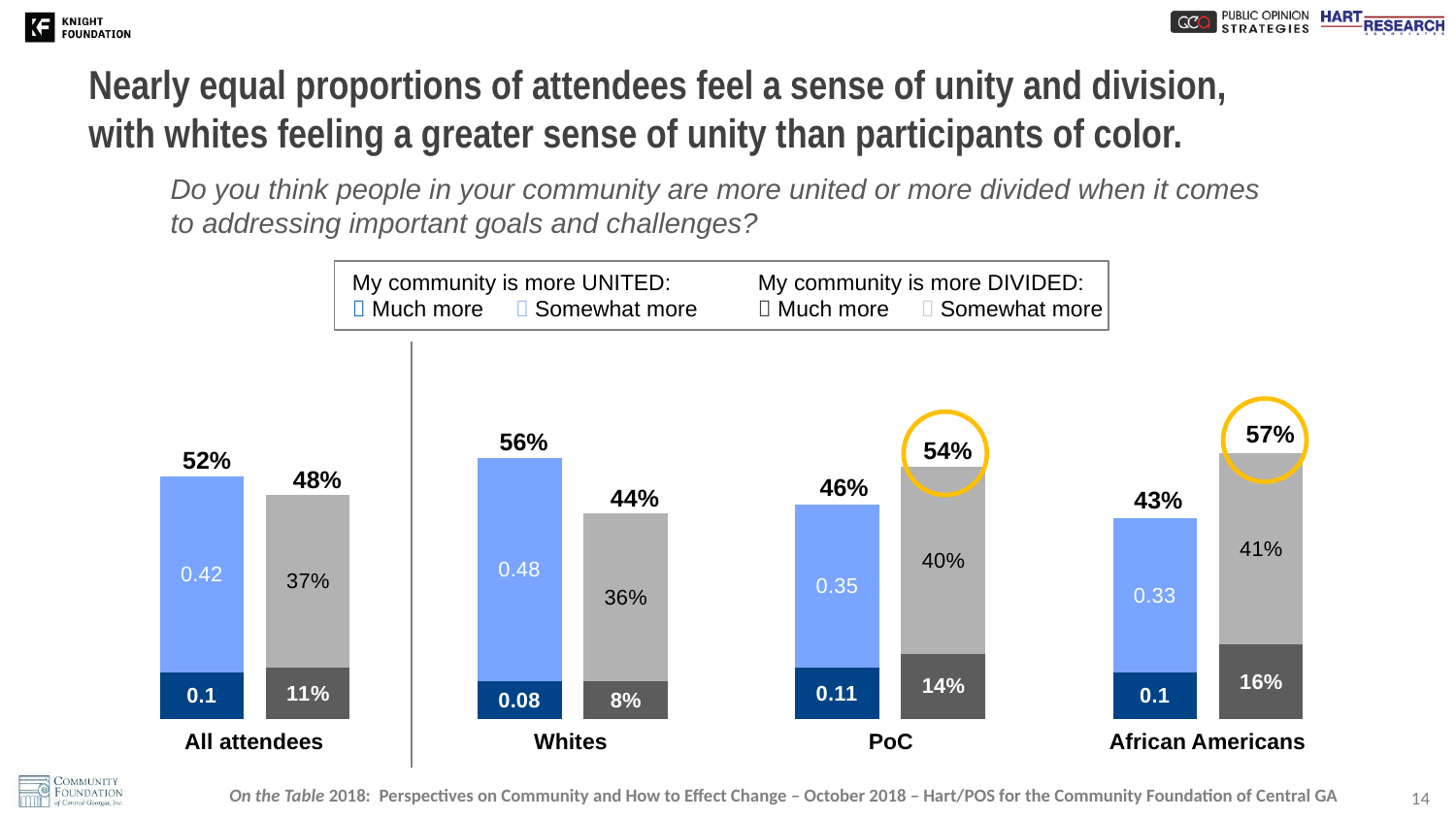
How many groups of attendees are shown along the x axis of the chart? 4 What value is shown for 'Somewhat more' UNITED among All attendees? 0.42 For PoC, which is larger: the total saying more UNITED or the total saying more DIVIDED? more DIVIDED How many entries does the chart's legend list? 4 Which two groups on the chart have their DIVIDED total circled in yellow? PoC and African Americans Which group has the lowest total percentage saying their community is more DIVIDED? Whites What percentage of PoC say their community is much more DIVIDED? 14% What kind of chart is shown on the slide? stacked bar chart Which group has the highest total percentage saying their community is more UNITED? Whites What is the total percentage of African Americans who say their community is more DIVIDED? 57% What is the total percentage of Whites who say their community is more UNITED? 56% What is the difference between the UNITED total and the DIVIDED total for African Americans? 14 percentage points